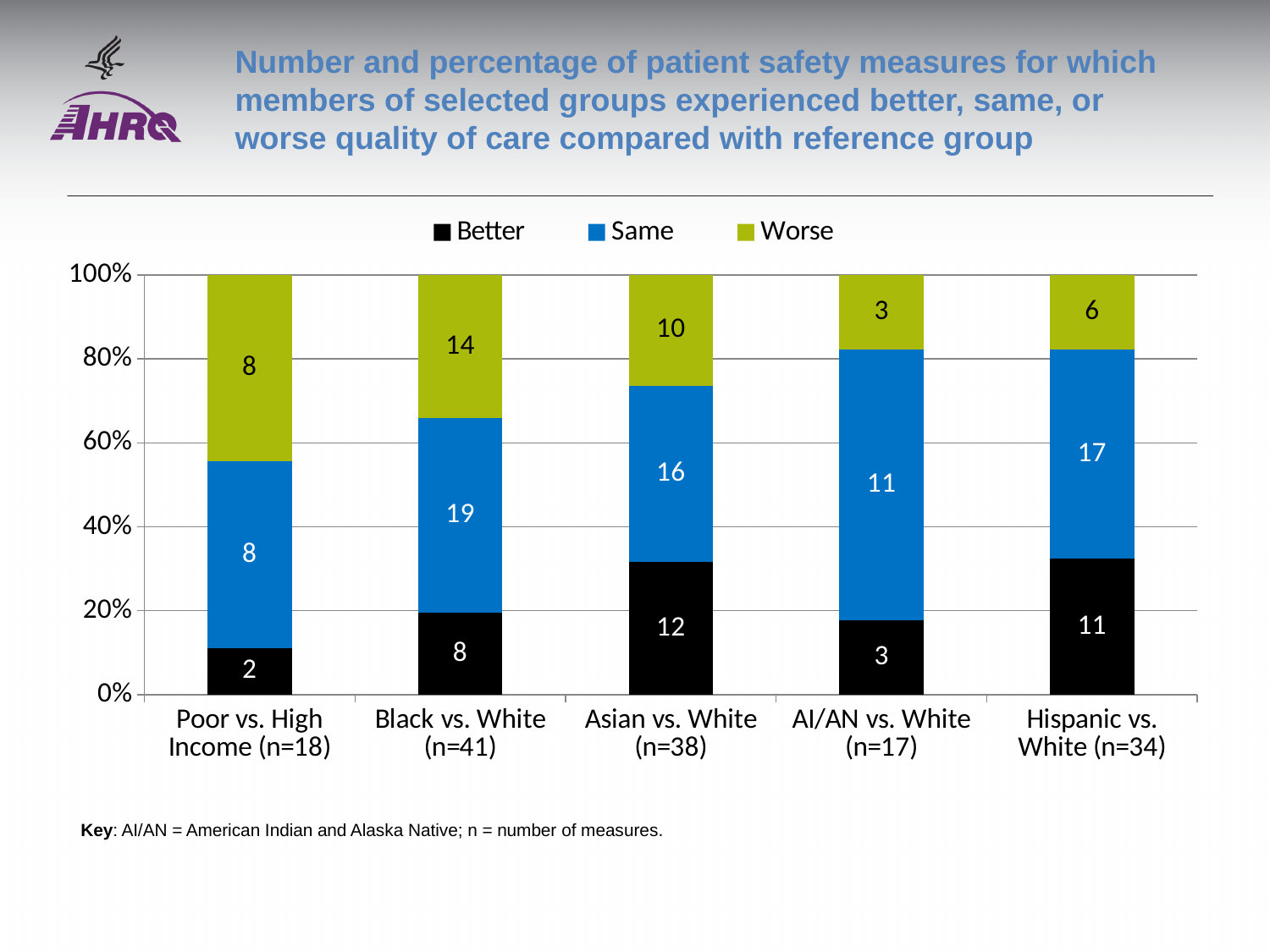
Which is larger, the Worse value for Asian vs. White (n=38) or the Worse value for Hispanic vs. White (n=34)? Asian vs. White (n=38) Which category has the highest Worse value? Black vs. White (n=41) How many series does the legend list? 3 What is the Same value for Black vs. White (n=41)? 19 What is the Same value for Hispanic vs. White (n=34)? 17 How many categories are shown on the x axis? 5 What is the Worse value for AI/AN vs. White (n=17)? 3 Which category has the lowest Better value? Poor vs. High Income (n=18) What is the total of the stacked bar for Black vs. White (n=41)? 41 What is the difference between the Same value and the Better value for Hispanic vs. White (n=34)? 6 What kind of chart is shown on the slide? Stacked bar chart What is the Better value for Asian vs. White (n=38)? 12